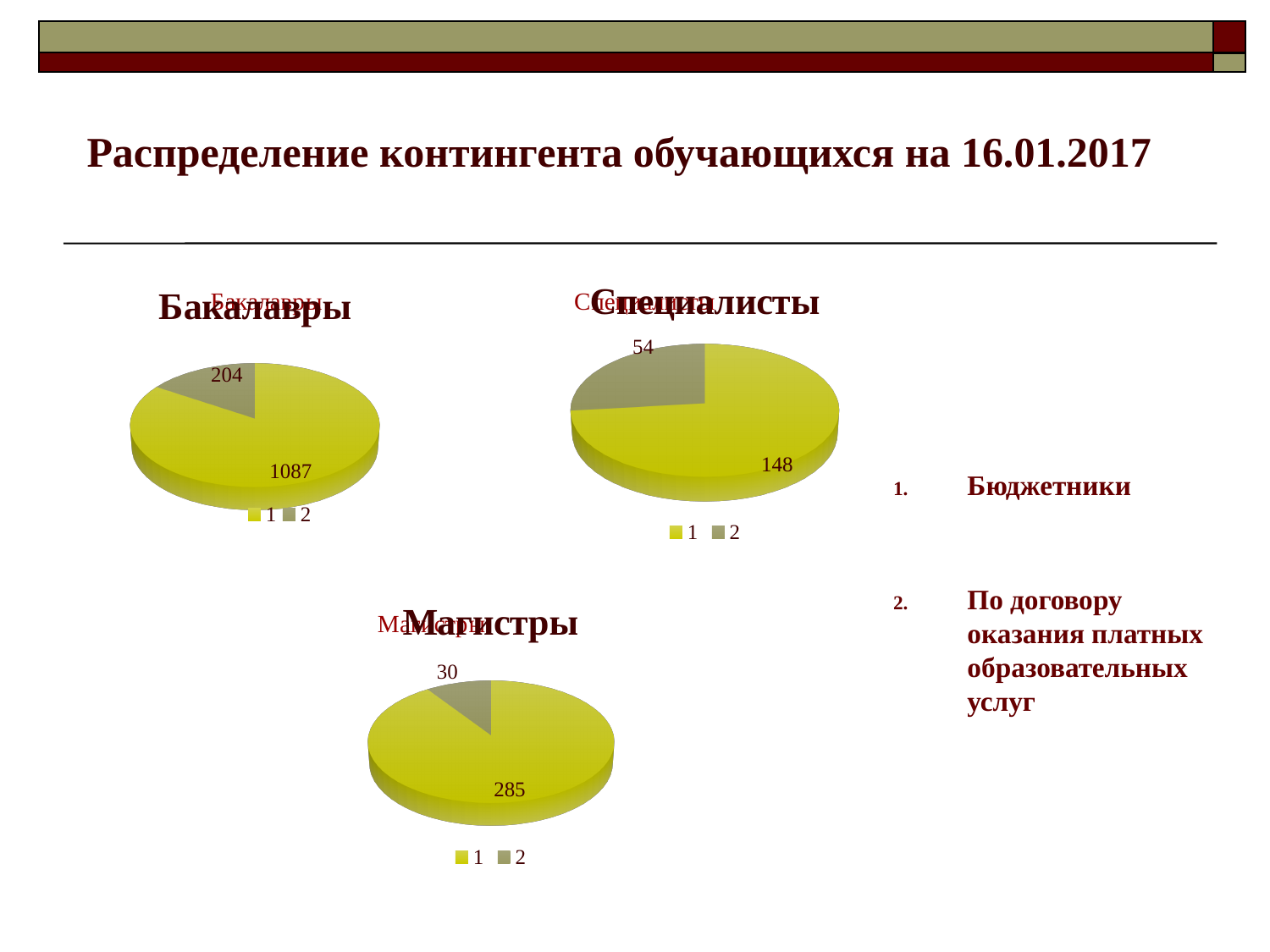
In the Бакалавры pie chart, what is the value for category 1? 1087 In the Магистры pie chart, which category has the largest slice? 1 What type of chart is used for Бакалавры, Специалисты and Магистры? Pie chart In the Бакалавры pie chart, what is the difference between the values for category 1 and category 2? 883 In the Бакалавры pie chart, what is the value for category 2? 204 In the Специалисты pie chart, what share of the total does category 2 represent? 26.7% In the Специалисты pie chart, which category has the smallest slice? 2 In the Магистры pie chart, what is the total of the two slices? 315 How many pie charts are shown on the slide? 3 In the Специалисты pie chart, what is the value for category 2? 54 In the Магистры pie chart, what is the value for category 2? 30 In the Специалисты pie chart, what is the value for category 1? 148